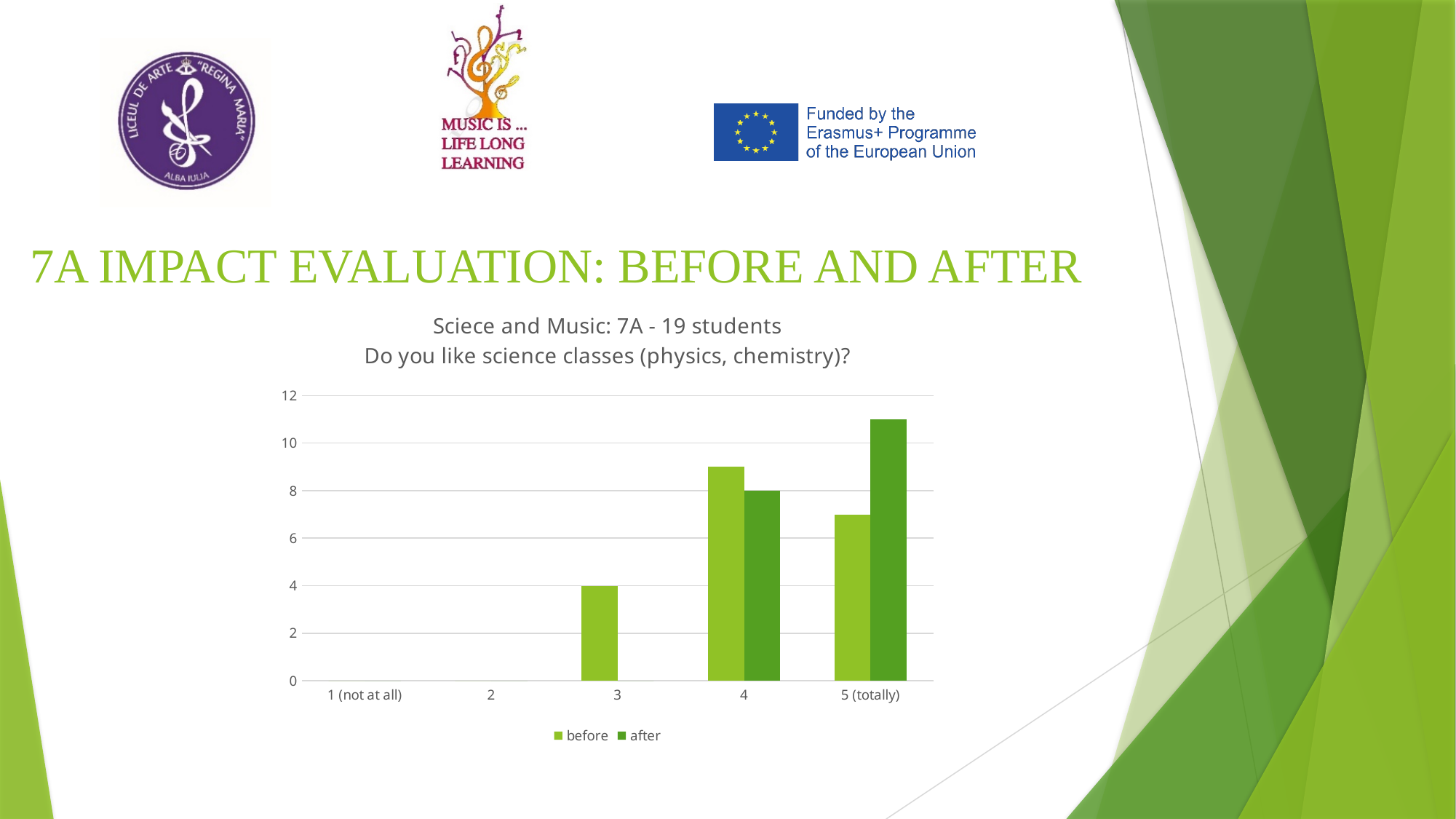
What is the 'before' value for category 3? 4 Is the 'before' value for category 4 greater or less than 8? greater How many series does the chart legend list? 2 Which category has the highest 'after' value? 5 (totally) What are the two series named in the chart legend? before and after Is the 'before' value for '5 (totally)' greater or less than 8? less What is the 'after' value for category 4? 8 For '5 (totally)', which is larger: the 'before' value or the 'after' value? after Is the 'after' value for '5 (totally)' greater or less than 10? greater Which category has the highest 'before' value? 4 How many categories are shown on the x axis of the chart? 5 What kind of chart is shown on the slide? bar chart